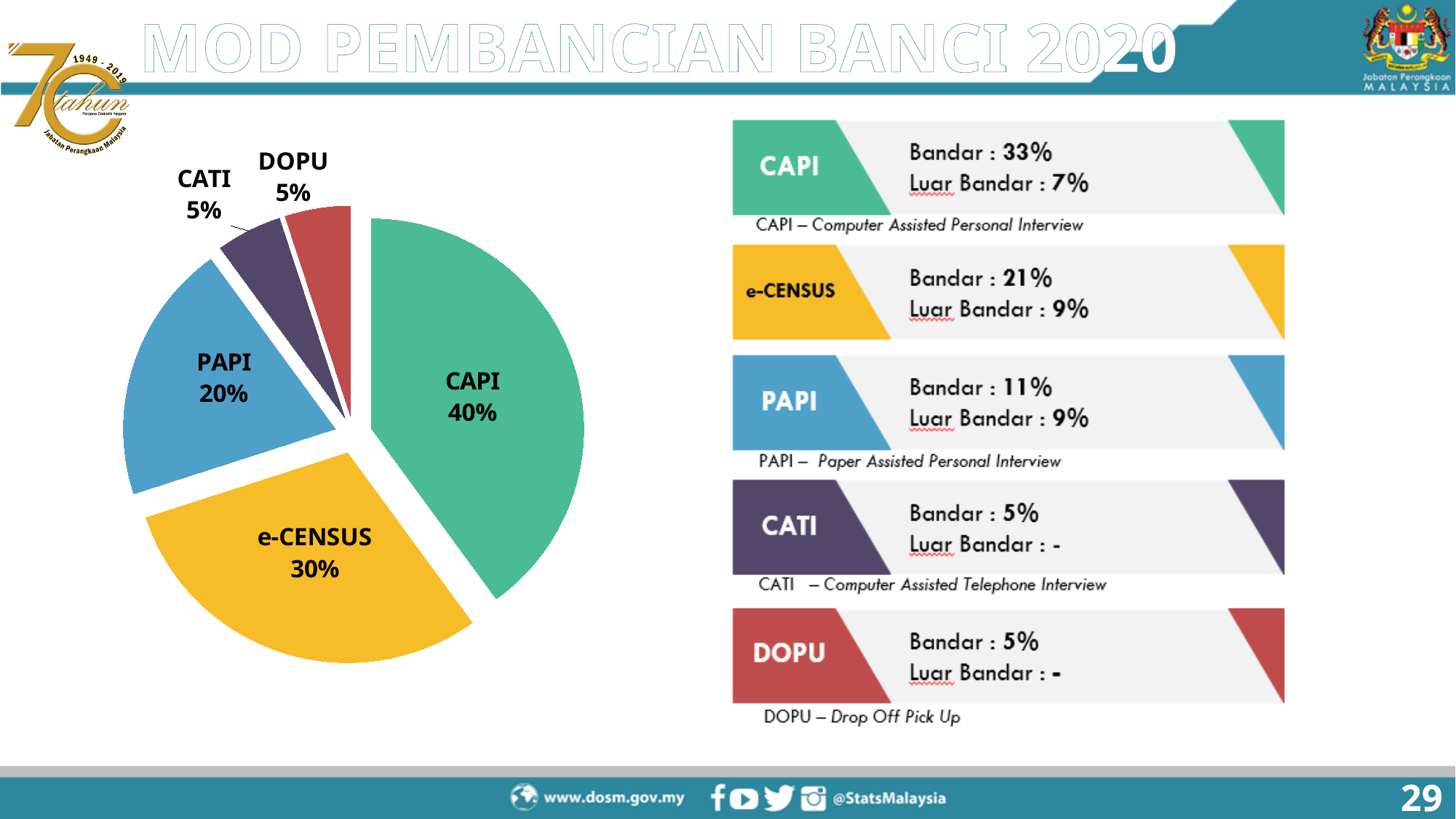
What is the value for e-CENSUS in the pie chart? 30% How many slices does the pie chart have? 5 Which category has the largest slice in the pie chart? CAPI Which is larger in the pie chart, PAPI or e-CENSUS? e-CENSUS What is the value for PAPI in the pie chart? 20% What is the value for CAPI in the pie chart? 40% What is the value for CATI in the pie chart? 5% What is the difference between the PAPI and DOPU values in the pie chart? 15% What is the difference between the CAPI and e-CENSUS values in the pie chart? 10% What is the combined share of CATI and DOPU in the pie chart? 10% What kind of chart is shown on the slide? pie chart What colour is the CAPI slice in the pie chart? green